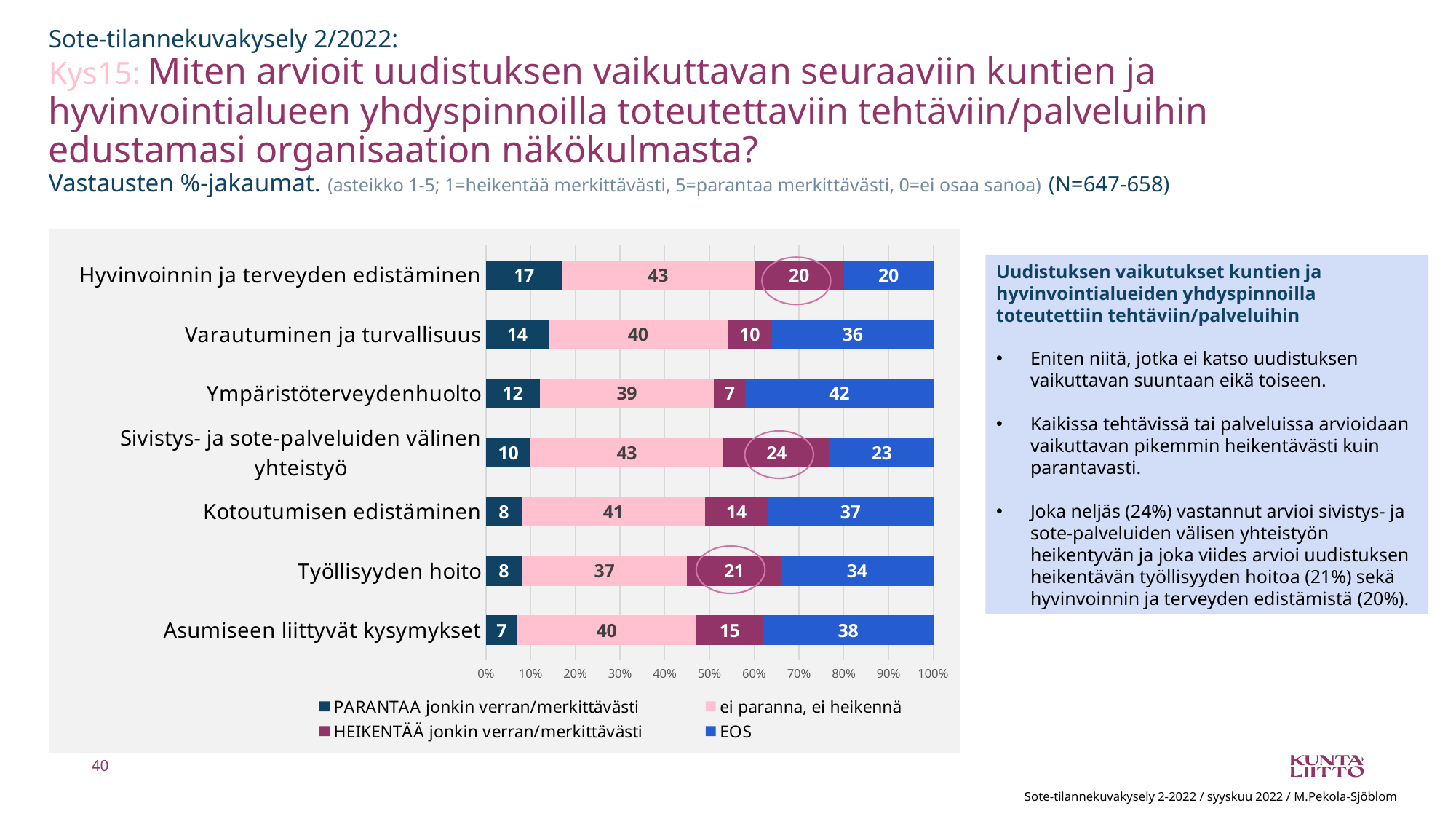
What is the HEIKENTÄÄ jonkin verran/merkittävästi value for Sivistys- ja sote-palveluiden välinen yhteistyö? 24 How many series does the legend list? 4 What is the PARANTAA jonkin verran/merkittävästi value for Hyvinvoinnin ja terveyden edistäminen? 17 What is the total of the four segments in the Varautuminen ja turvallisuus bar? 100 What is the difference between the EOS values for Ympäristöterveydenhuolto and Hyvinvoinnin ja terveyden edistäminen? 22 How many categories (tasks/services) are shown in the chart? 7 What is the 'ei paranna, ei heikennä' value for Työllisyyden hoito? 37 Which is larger: the HEIKENTÄÄ value for Kotoutumisen edistäminen or for Asumiseen liittyvät kysymykset? Asumiseen liittyvät kysymykset Which category has the highest PARANTAA jonkin verran/merkittävästi value? Hyvinvoinnin ja terveyden edistäminen Which category has the lowest HEIKENTÄÄ jonkin verran/merkittävästi value? Ympäristöterveydenhuolto What is the EOS value for Ympäristöterveydenhuolto? 42 What type of chart is shown on the slide? stacked bar chart